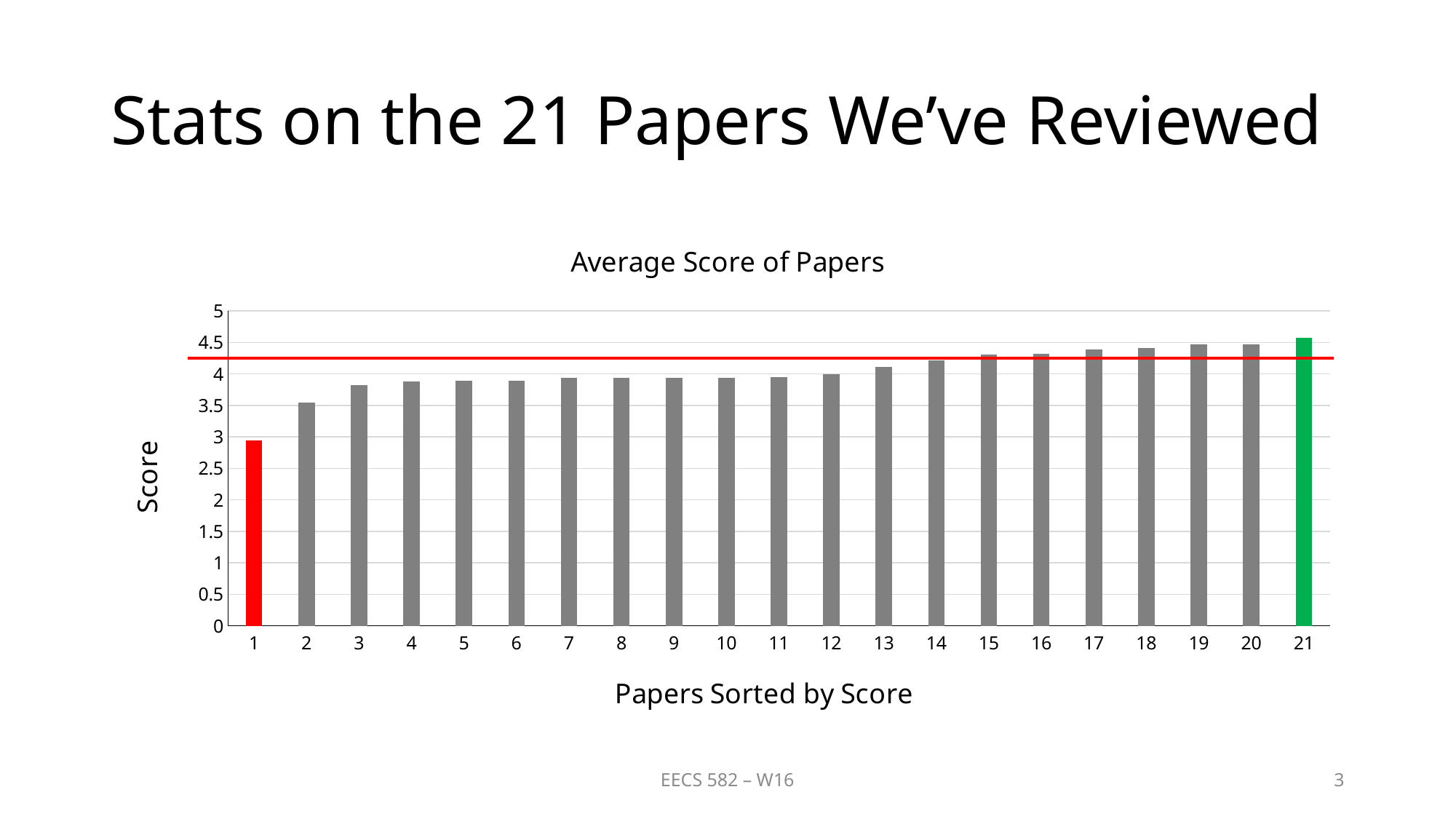
Which paper has the highest average score? 21 Is the score for paper 20 greater or less than 4? greater How many papers (bars) are plotted in the chart? 21 Which has the larger score, paper 2 or paper 20? paper 20 Is the score for paper 12 greater or less than 3.5? greater What kind of chart is shown on the slide? bar chart Is the score for paper 1 greater or less than 3.5? less Do the scores rise or fall from paper 1 to paper 21 along the x axis? rise What is the label on the x axis of the chart? Papers Sorted by Score What is the title of the chart? Average Score of Papers Which paper has the lowest average score? 1